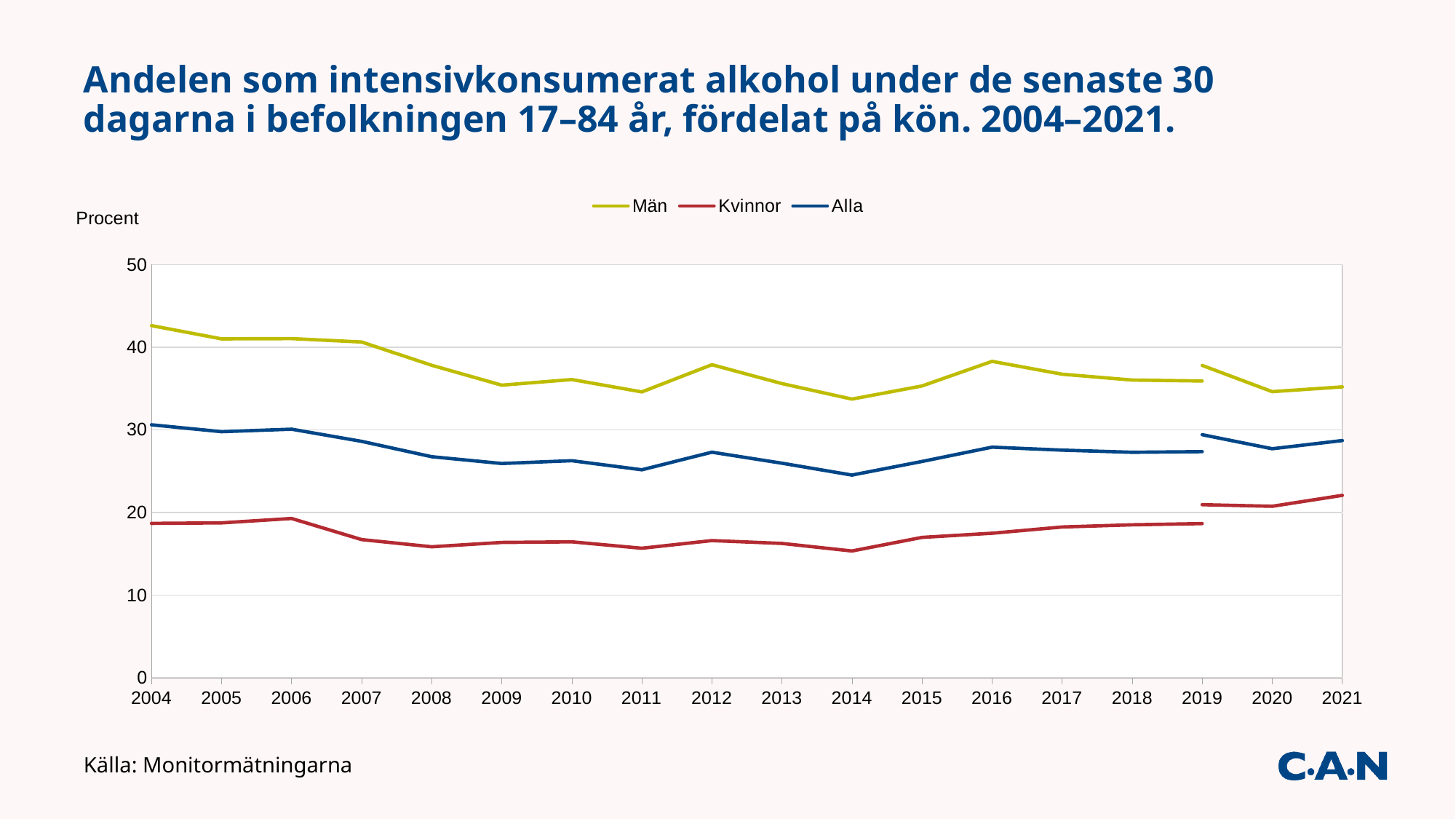
Is the value for Kvinnor in 2021 greater or less than 20? greater In which year is the value for Kvinnor highest? 2021 Is the value for Alla in 2014 greater or less than 30? less How many series does the legend list? 3 Is the value for Män in 2004 greater or less than 40? greater Does the value for Män rise or fall from 2004 to 2014? Fall Which series has the higher value in 2012, Män or Kvinnor? Män In which year is the value for Män highest? 2004 What kind of chart is shown on the slide? Line chart How many years are plotted along the x axis? 18